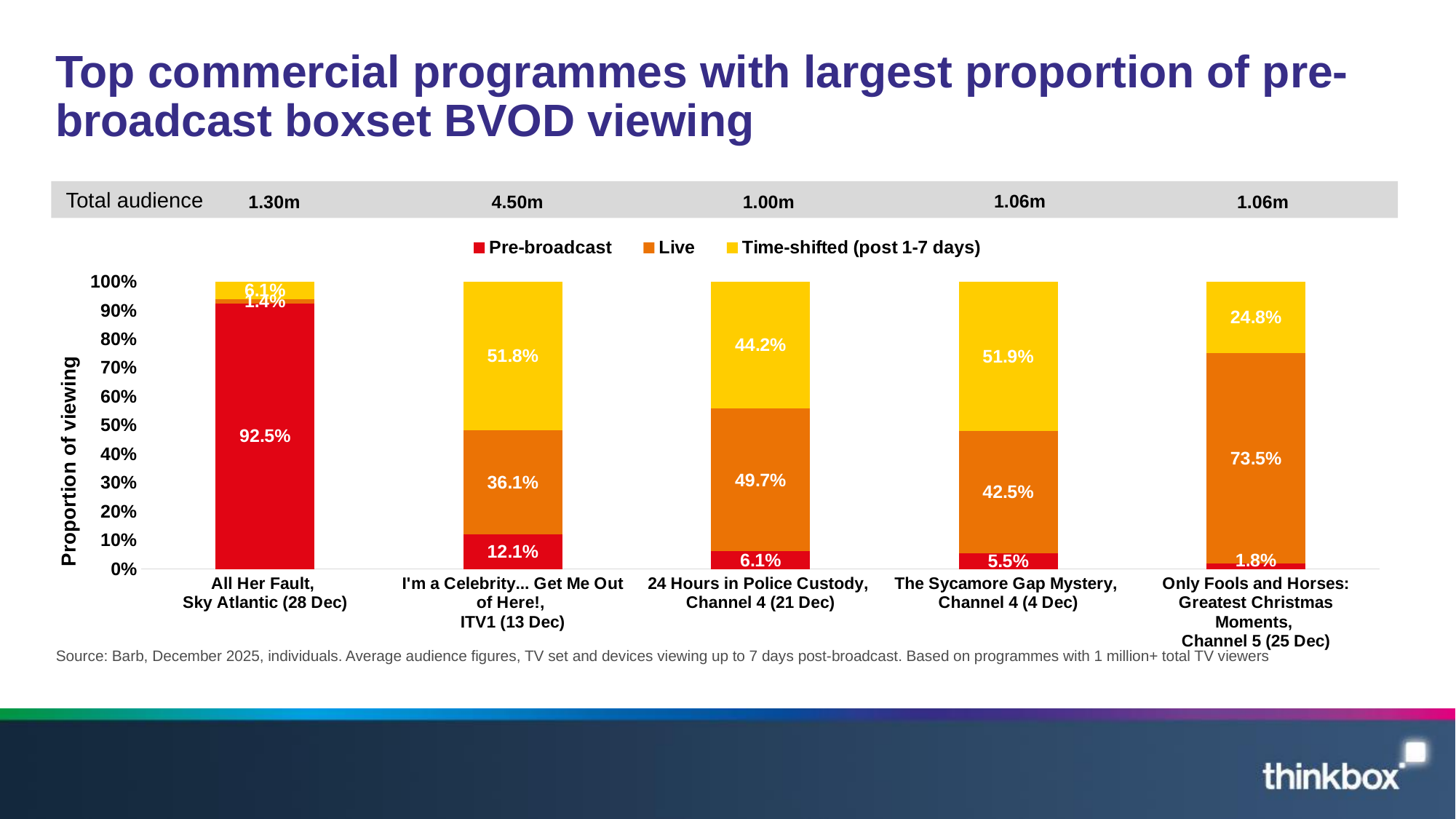
What is the Pre-broadcast share for All Her Fault, Sky Atlantic (28 Dec)? 92.5% How many programmes are shown on the chart? 5 Which programme has the lowest Pre-broadcast share? Only Fools and Horses: Greatest Christmas Moments, Channel 5 (25 Dec) Which is larger: the Time-shifted (post 1-7 days) share for I'm a Celebrity... Get Me Out of Here!, ITV1 (13 Dec) or for Only Fools and Horses: Greatest Christmas Moments, Channel 5 (25 Dec)? I'm a Celebrity... Get Me Out of Here!, ITV1 (13 Dec) Which programme has the highest Pre-broadcast share? All Her Fault, Sky Atlantic (28 Dec) How many series does the legend list? 3 What is the Time-shifted (post 1-7 days) share for 24 Hours in Police Custody, Channel 4 (21 Dec)? 44.2% What kind of chart is shown on the slide? Stacked bar chart What is the Pre-broadcast share for I'm a Celebrity... Get Me Out of Here!, ITV1 (13 Dec)? 12.1% What is the Live share for Only Fools and Horses: Greatest Christmas Moments, Channel 5 (25 Dec)? 73.5% What is the difference between the Live share for 24 Hours in Police Custody, Channel 4 (21 Dec) and the Live share for The Sycamore Gap Mystery, Channel 4 (4 Dec)? 7.2% What is the total audience shown for I'm a Celebrity... Get Me Out of Here!, ITV1 (13 Dec)? 4.50m